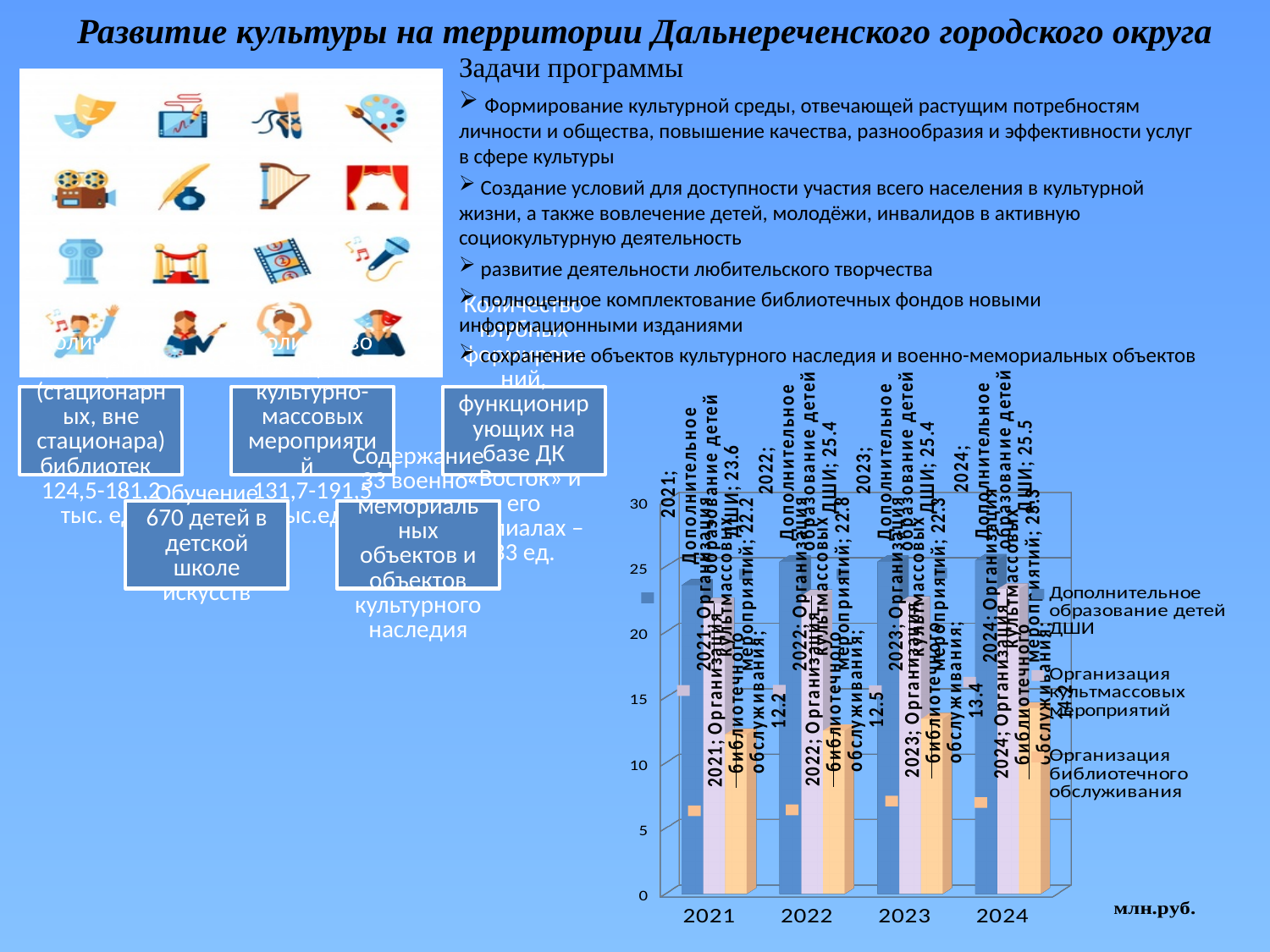
What is the value for Организация культмассовых мероприятий in 2022? 22.8 Do the values for Организация библиотечного обслуживания rise or fall from 2021 to 2024? rise What is the value for Дополнительное образование детей ДШИ in 2021? 23.6 What is the value for Организация библиотечного обслуживания in 2021? 12.2 What unit is indicated in the bottom-right corner of the chart? млн.руб. How many series does the chart legend list? 3 How many years are shown on the x axis of the chart? 4 Is the value for Организация библиотечного обслуживания in 2024 greater or less than 20? less In 2023, which is larger: Дополнительное образование детей ДШИ or Организация культмассовых мероприятий? Дополнительное образование детей ДШИ What kind of chart is shown on the slide? bar chart What is the difference between Дополнительное образование детей ДШИ and Организация библиотечного обслуживания in 2022? 12.9 What is the value for Организация библиотечного обслуживания in 2023? 13.4